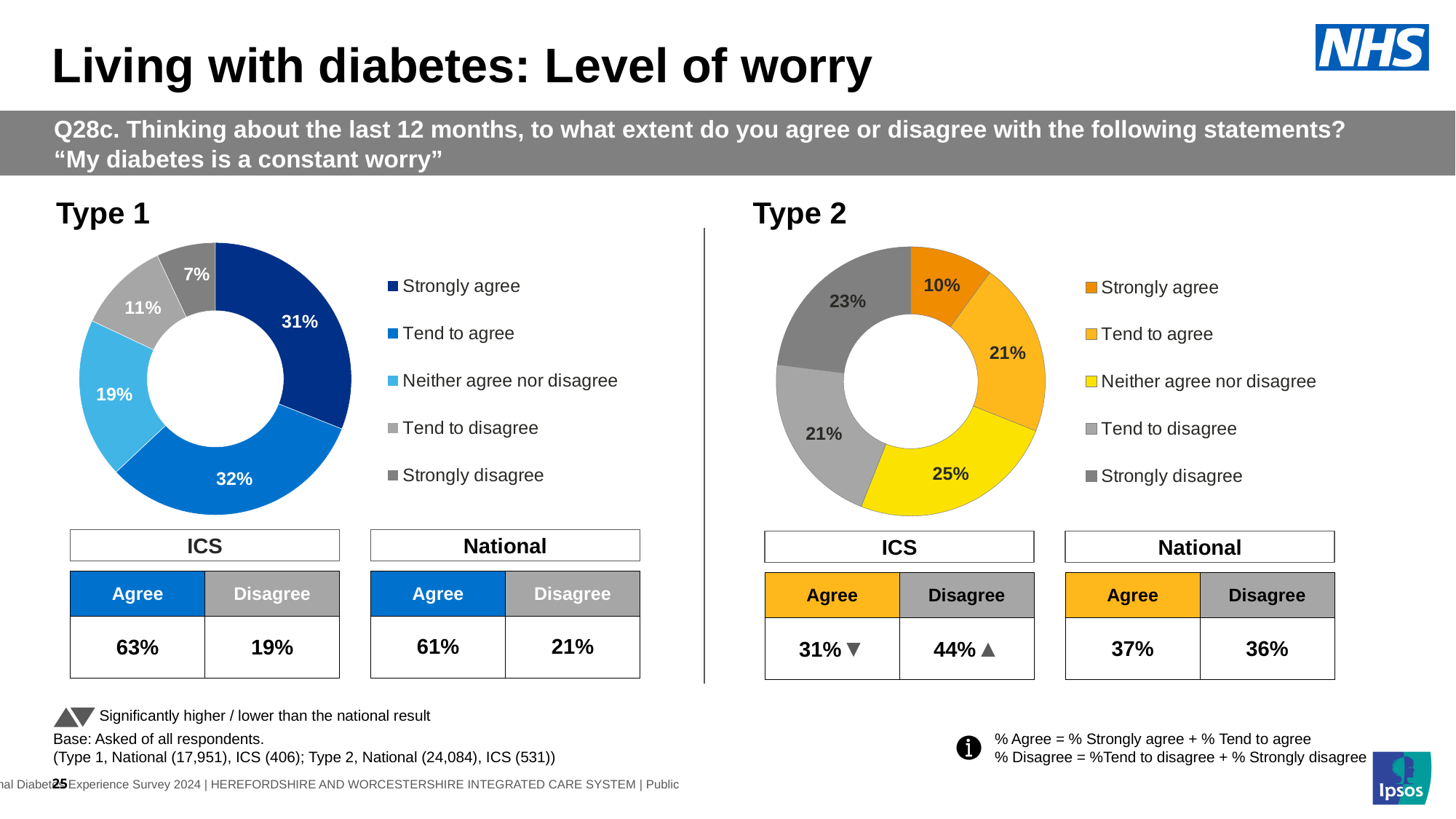
In the Type 1 chart, what percentage of respondents said they tend to disagree? 11% In the Type 2 chart, which response category has the smallest share? Strongly agree How many response categories does the legend of the Type 2 chart list? 5 In the Type 1 chart, what is the difference between the Tend to agree share and the Neither agree nor disagree share? 13% Which is larger: the Strongly agree share in the Type 1 chart or the Strongly agree share in the Type 2 chart? Type 1 In the Type 2 chart, which response category has the largest share? Neither agree nor disagree In the Type 1 chart, which response category has the largest share? Tend to agree In the Type 2 chart, what percentage of respondents said they strongly disagree? 23% In the Type 1 chart, which response category has the smallest share? Strongly disagree In the Type 1 chart, what percentage of respondents said they strongly agree? 31% In the Type 2 chart, what percentage of respondents said they neither agree nor disagree? 25% What kind of chart is used to show the Type 1 results? Donut (pie) chart